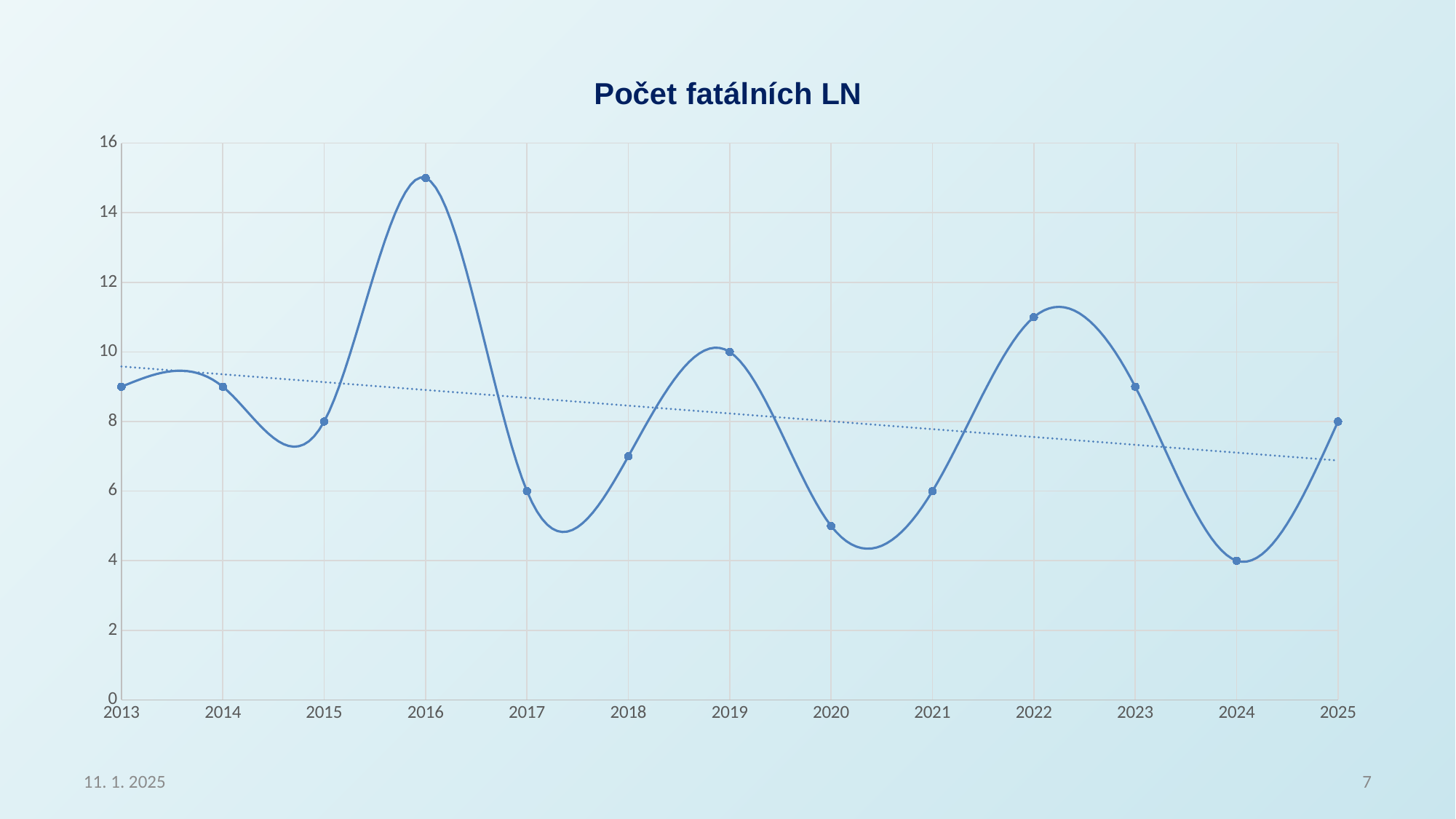
What is the value for 2025? 8 Is the value for 2016 greater or less than 14? greater What kind of chart is shown on the slide? line chart Which year has the lowest value? 2024 Is the value for 2020 greater or less than 6? less What is the value for 2017? 6 What is the value for 2019? 10 What is the difference between the values for 2019 and 2017? 4 How many years are plotted on the x axis? 13 Which year has the highest value? 2016 What is the title of the chart? Počet fatálních LN What is the value for 2024? 4